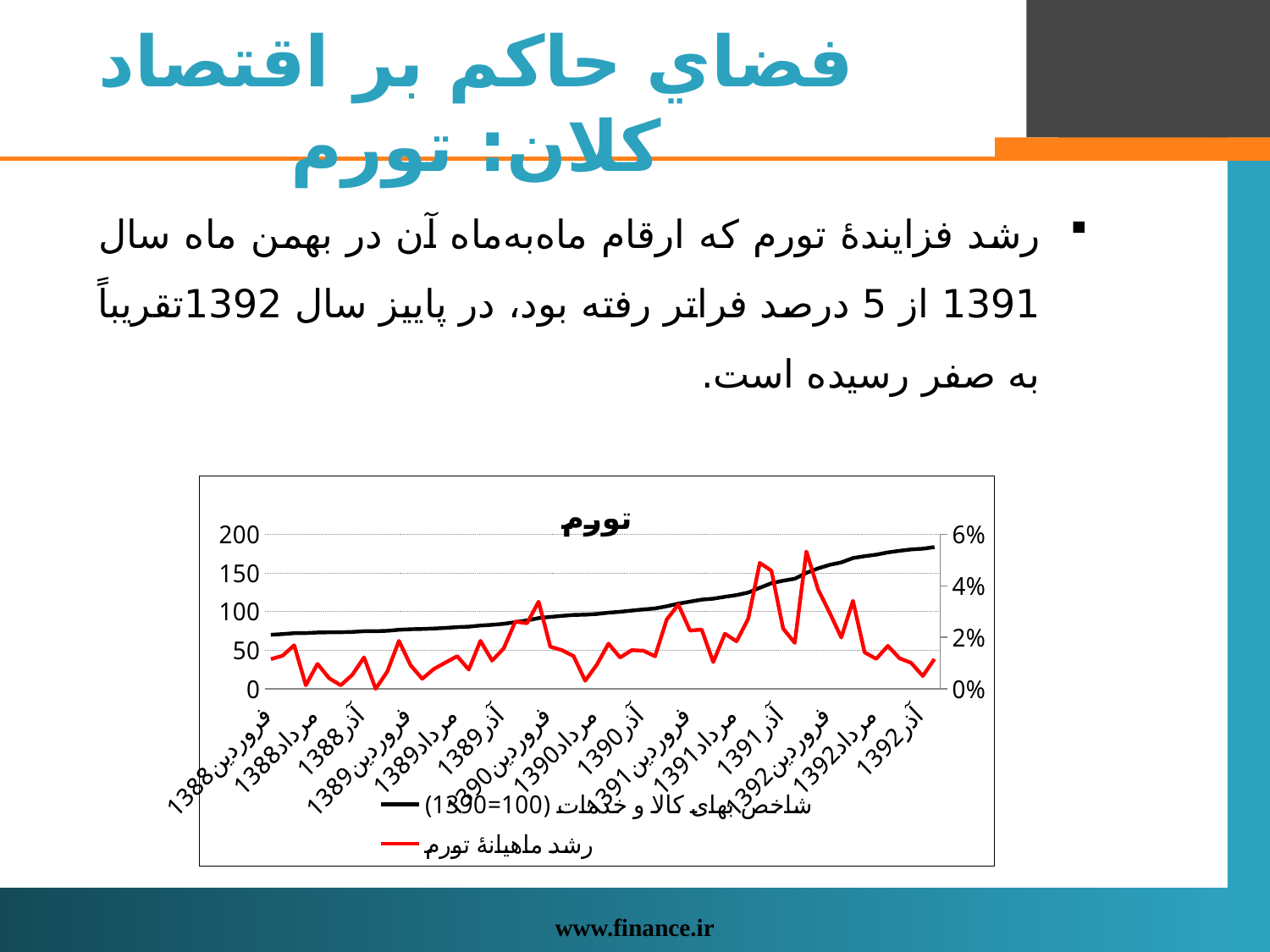
Which is larger for شاخص بهای کالا و خدمات (1390=100): the value at فروردین 1388 or the value at آذر 1392? آذر 1392 What type of chart is shown on the slide? line chart Is the highest value of رشد ماهیانۀ تورم greater or less than 4%? greater What is the maximum value shown on the left vertical axis? 200 What is the title of the chart? تورم Is the value of شاخص بهای کالا و خدمات (1390=100) at آذر 1392 greater or less than 150? greater How many series does the chart legend list? 2 Is the value of رشد ماهیانۀ تورم at آذر 1392 greater or less than 2%? less Which series is drawn in red? رشد ماهیانۀ تورم Does the series شاخص بهای کالا و خدمات (1390=100) rise or fall along the x axis? rise How many category labels are shown on the x axis? 15